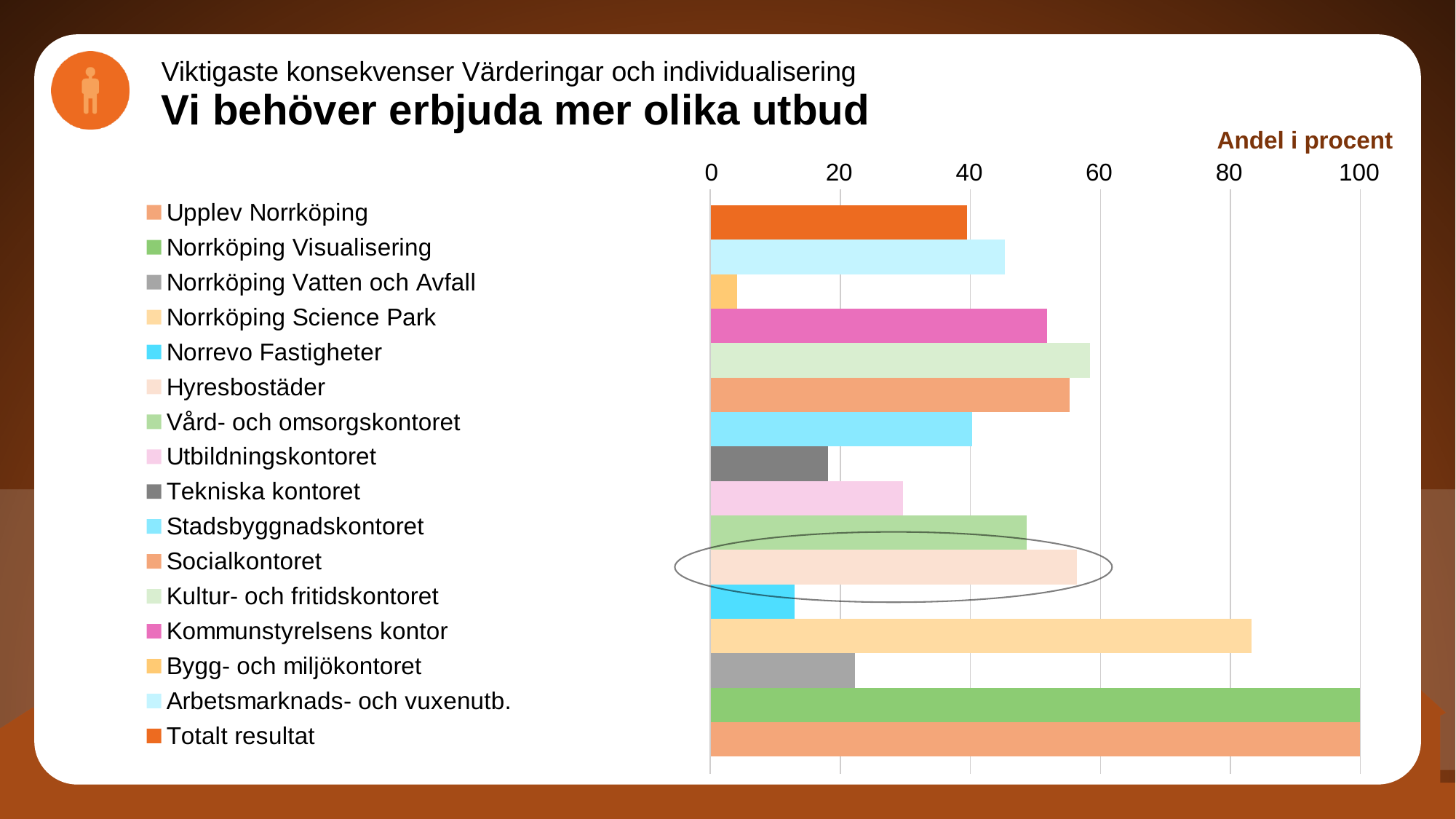
Is the value for Tekniska kontoret greater or less than 40? less How many bars are plotted in the chart? 16 Is the value for Kommunstyrelsens kontor greater or less than 40? greater What kind of chart is shown on the slide? bar chart Which is larger, the value for Tekniska kontoret or the value for Utbildningskontoret? Utbildningskontoret Which is larger, the value for Norrköping Science Park or the value for Hyresbostäder? Norrköping Science Park How many entries does the legend list? 16 Is the value for Norrköping Science Park greater or less than 60? greater Which category has the lowest value in the chart? Bygg- och miljökontoret What label is shown above the horizontal axis of the chart? Andel i procent